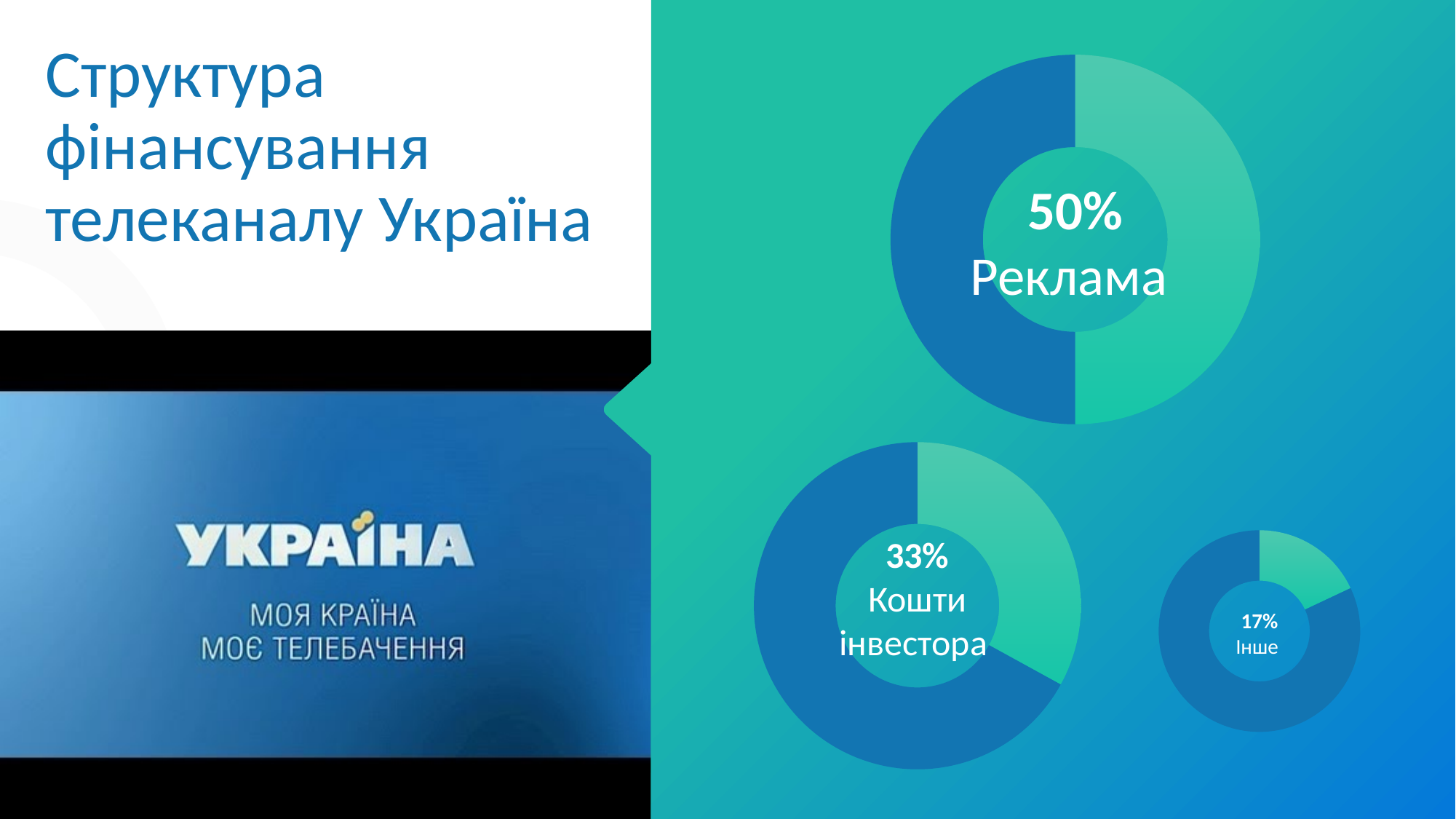
What share of the financing structure does Реклама account for, according to the largest donut chart? 50% How many financing categories are shown as separate donut charts on the slide? 3 What percentage is shown in the smallest donut chart, labelled Інше? 17% Which financing source has the smallest share across the three donut charts? Інше What is the difference in percentage points between the Реклама share and the Кошти інвестора share? 17 What do the three percentages shown in the donut charts (Реклама, Кошти інвестора, Інше) add up to? 100% What is the difference in percentage points between the Кошти інвестора share and the Інше share? 16 What is the title of the slide containing the donut charts? Структура фінансування телеканалу Україна What percentage is shown in the donut chart labelled Кошти інвестора? 33% What kind of charts are used on the right side of the slide to show the financing structure? Donut (pie) charts Which financing source has the largest share across the three donut charts? Реклама Which is larger: the share for Кошти інвестора or the share for Інше? Кошти інвестора